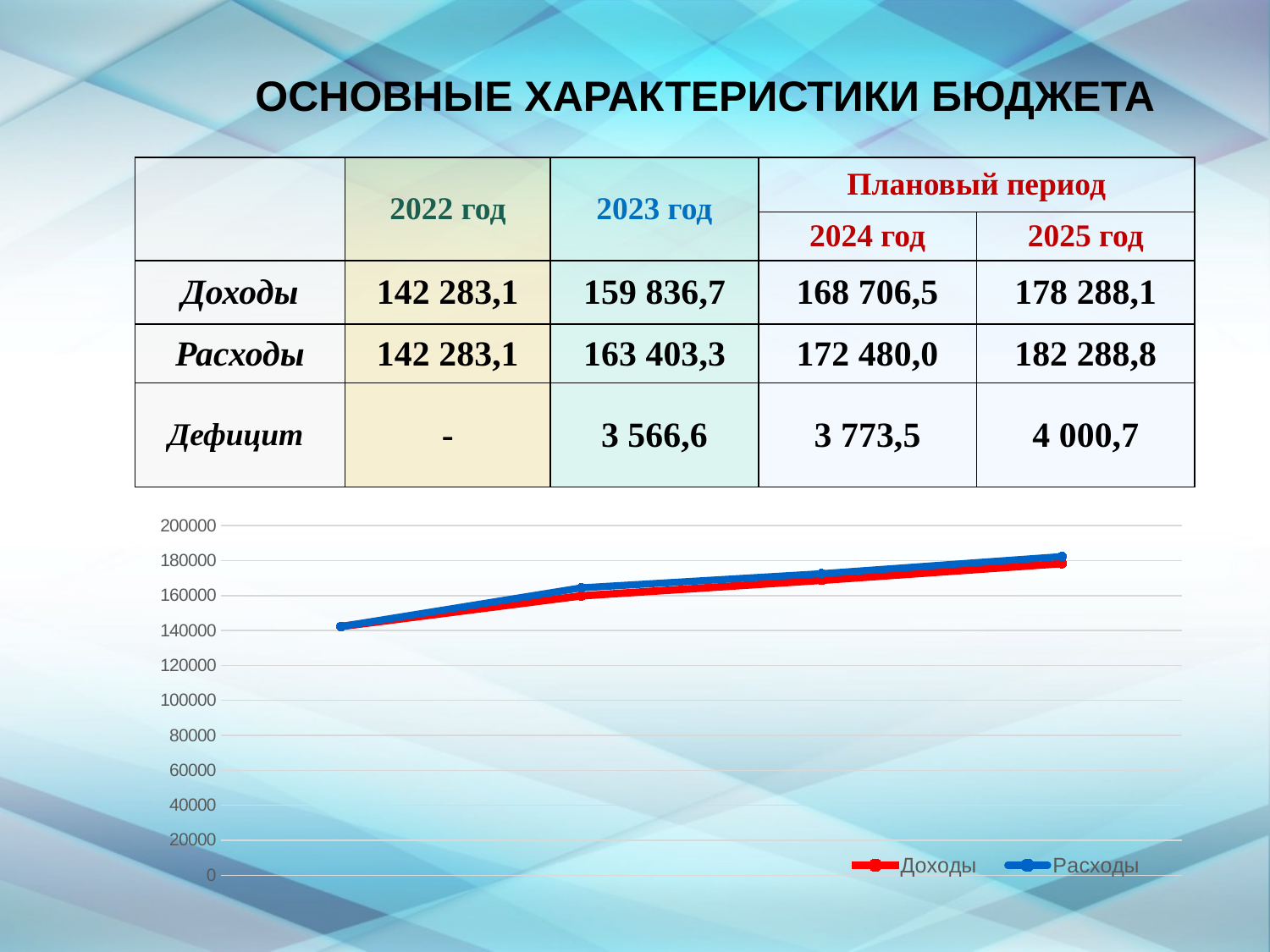
What is the highest value shown on the chart's vertical axis? 200000 What are the two series named in the chart legend? Доходы and Расходы Is the third value of the Расходы line greater or less than 160000? greater Which colour is used for the Расходы line in the chart? blue Is the last (rightmost) value of the Доходы line greater or less than 200000? less Is the last (rightmost) value of the Расходы line greater or less than 160000? greater How many series does the chart legend list? 2 What kind of chart is shown at the bottom of the slide? line chart Do the values of the Доходы line rise or fall from left to right along the x axis? rise Do the values of the Расходы line rise or fall from left to right along the x axis? rise How many data points does each line in the chart have? 4